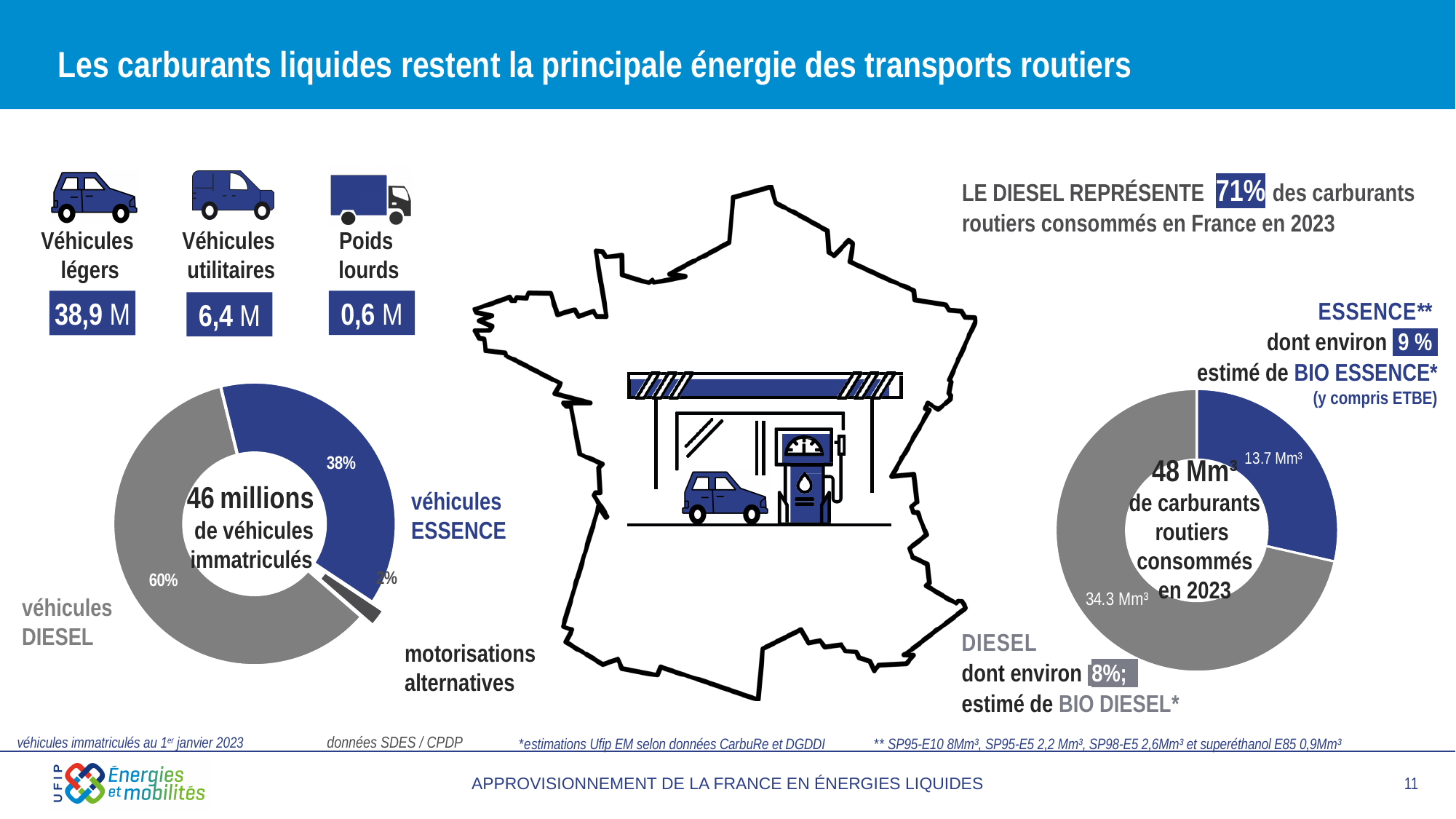
On the right donut chart (48 Mm³ de carburants routiers consommés en 2023), what is the value for DIESEL? 34.3 Mm³ What type of chart is used for the 46 millions de véhicules immatriculés breakdown on the left? Donut (pie) chart On the right donut chart (48 Mm³ de carburants routiers consommés en 2023), what is the value for ESSENCE? 13.7 Mm³ On the left donut chart (46 millions de véhicules immatriculés), what share of registered vehicles is véhicules DIESEL? 60% On the left donut chart (46 millions de véhicules immatriculés), what is the difference in percentage points between véhicules DIESEL and véhicules ESSENCE? 22 percentage points On the right donut chart (48 Mm³ de carburants routiers consommés en 2023), what is the difference between DIESEL and ESSENCE? 20.6 Mm³ On the left donut chart (46 millions de véhicules immatriculés), what share is motorisations alternatives? 2% On the right donut chart (48 Mm³ de carburants routiers consommés en 2023), which is larger, DIESEL or ESSENCE? DIESEL On the left donut chart (46 millions de véhicules immatriculés), which category has the smallest share? motorisations alternatives On the left donut chart (46 millions de véhicules immatriculés), what share of registered vehicles is véhicules ESSENCE? 38% On the left donut chart (46 millions de véhicules immatriculés), which category has the largest share? véhicules DIESEL On the left donut chart (46 millions de véhicules immatriculés), how many categories are shown? 3